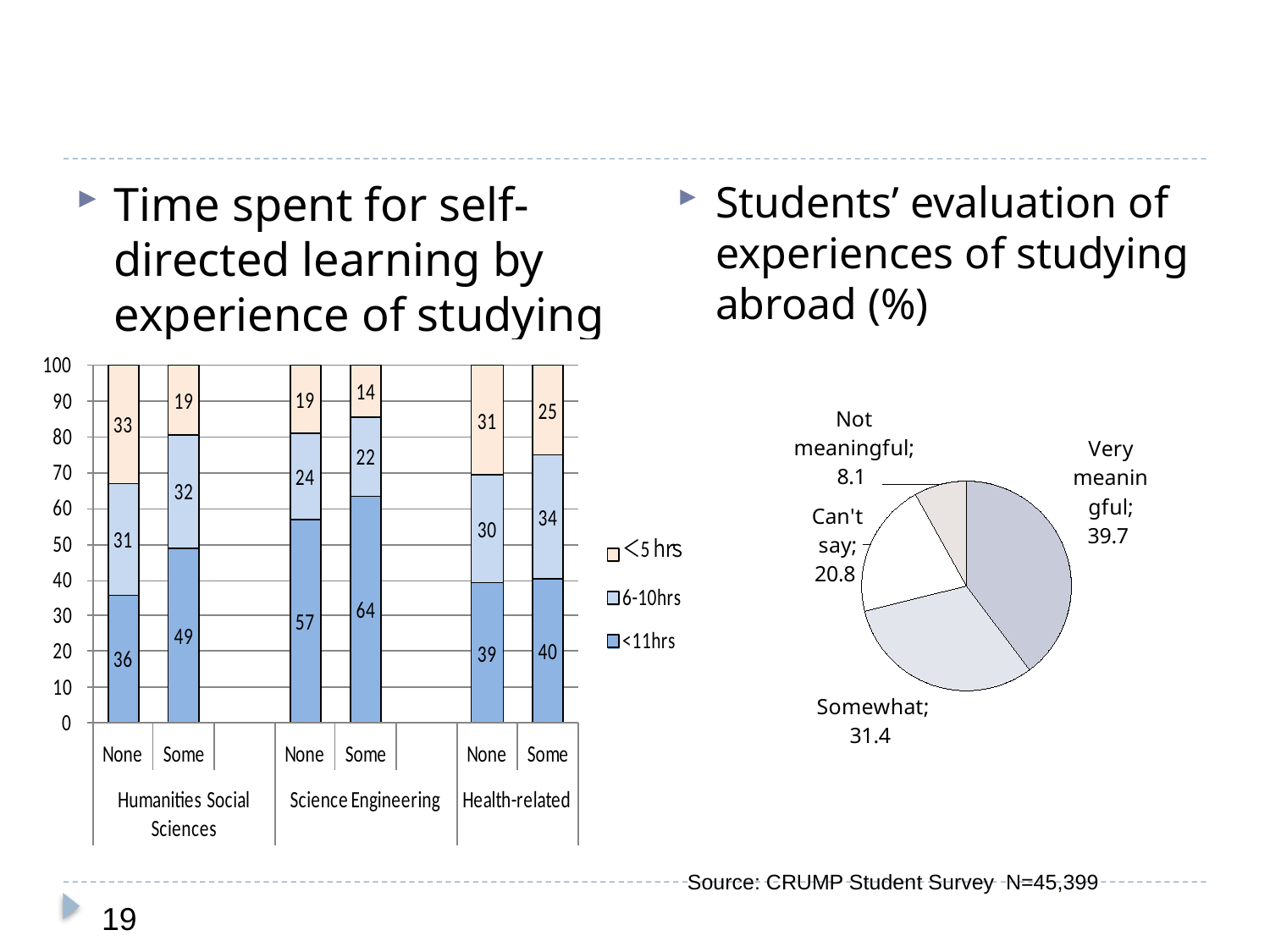
In the left bar chart, what is the value of the 6-10hrs segment for Health-related students with Some study-abroad experience? 34 In the left bar chart, which bar has the highest <11hrs value? Science Engineering, Some In the left bar chart, which is larger: the <5 hrs value for Health-related None or for Health-related Some? Health-related None In the right pie chart, what share is labelled Very meaningful? 39.7 How many series does the legend of the left bar chart list? 3 How many slices does the right pie chart have? 4 What kind of chart is on the left of the slide? Stacked bar chart In the left bar chart, what is the difference between the <11hrs values for Humanities Social Sciences None and Some? 13 In the left bar chart, what is the value of the <11hrs segment for Science Engineering students with Some study-abroad experience? 64 In the left bar chart, what is the value of the <5 hrs segment for Humanities Social Sciences students with None study-abroad experience? 33 In the right pie chart, what is the difference between the Somewhat and Can't say slices? 10.6 In the right pie chart, which slice is the smallest? Not meaningful